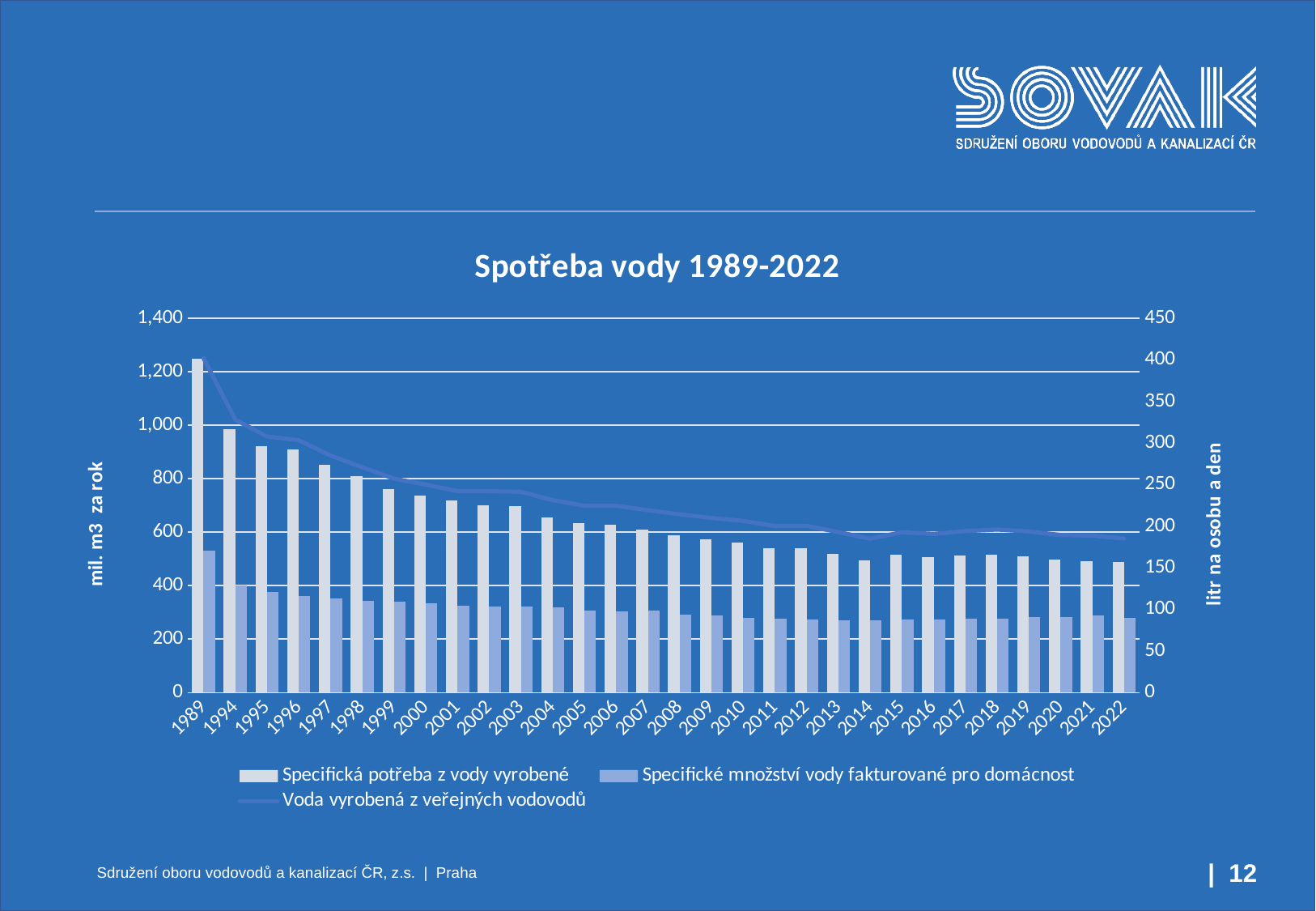
What kind of chart is shown on the slide? A combined bar and line chart What is the title of the chart? Spotřeba vody 1989-2022 Do the values for Specifická potřeba z vody vyrobené generally rise or fall from 1989 to 2022? Fall How many years are shown on the x axis? 30 Which year has the highest value for Specifická potřeba z vody vyrobené? 1989 Is the value for Specifická potřeba z vody vyrobené in 1995 greater or less than 1,000? less Which year has the highest value for Specifické množství vody fakturované pro domácnost? 1989 How many series does the legend list? 3 What is the label of the right-hand vertical axis? litr na osobu a den Is the value for Specifická potřeba z vody vyrobené in 2010 greater or less than 600? less Which is larger, the Specifická potřeba z vody vyrobené value for 1989 or for 1994? 1989